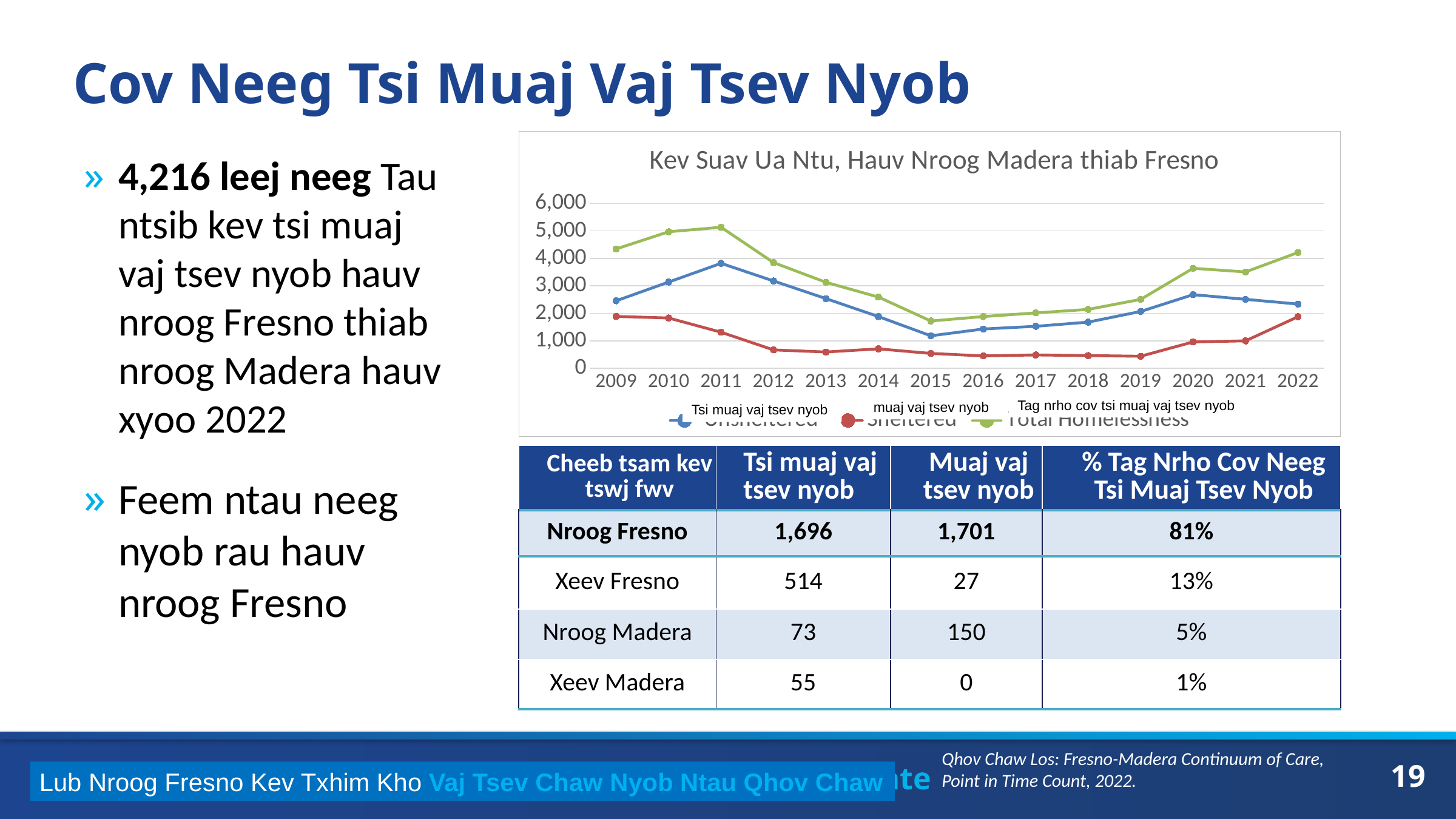
Is the Unsheltered (blue) value for 2011 greater or less than 3,000? greater What kind of chart is shown on the slide? line chart Is the Sheltered (red) value for 2016 greater or less than 1,000? less Is the Total Homelessness value for 2011 greater or less than 5,000? greater What is the title of the chart? Kev Suav Ua Ntu, Hauv Nroog Madera thiab Fresno How many series does the chart's legend list? 3 How many years are plotted along the x axis of the chart? 14 In which year does the Total Homelessness (green) line reach its lowest value? 2015 Which is larger in 2011: the Unsheltered value or the Sheltered value? Unsheltered In which year does the Total Homelessness (green) line reach its highest value? 2011 Does the Total Homelessness line rise or fall from 2015 to 2022? rise